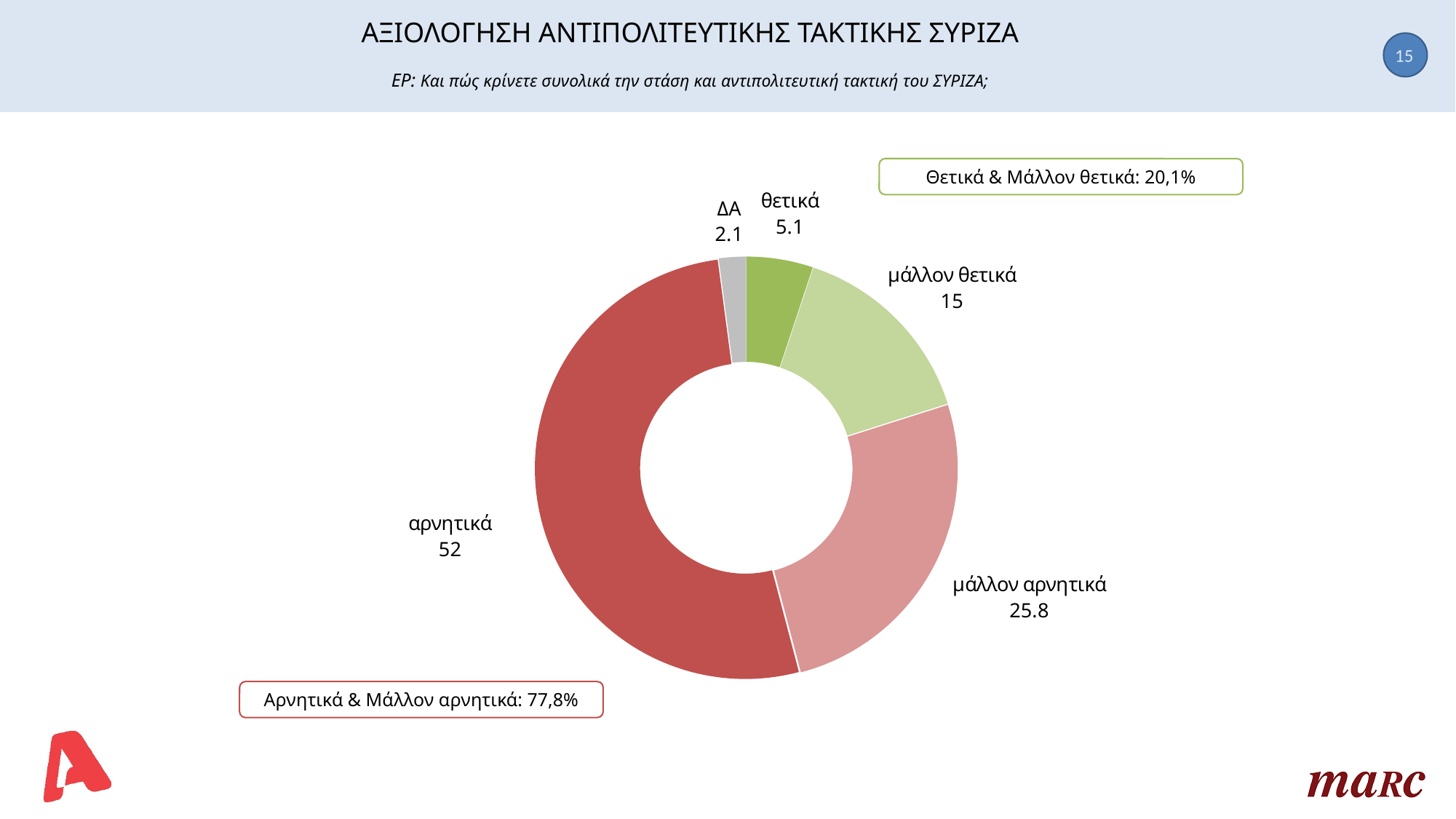
Which category has the smallest slice? ΔΑ Which is larger, μάλλον θετικά or θετικά? μάλλον θετικά What combined percentage does the slide give for Θετικά & Μάλλον θετικά? 20,1% What value is shown for the αρνητικά slice? 52 What is the difference between the αρνητικά and μάλλον αρνητικά values? 26.2 What value is shown for the ΔΑ slice? 2.1 What value is shown for the θετικά slice? 5.1 What value is shown for the μάλλον αρνητικά slice? 25.8 What value is shown for the μάλλον θετικά slice? 15 Which category has the largest slice? αρνητικά What kind of chart is shown on the slide? Donut (pie) chart How many slices does the chart have? 5